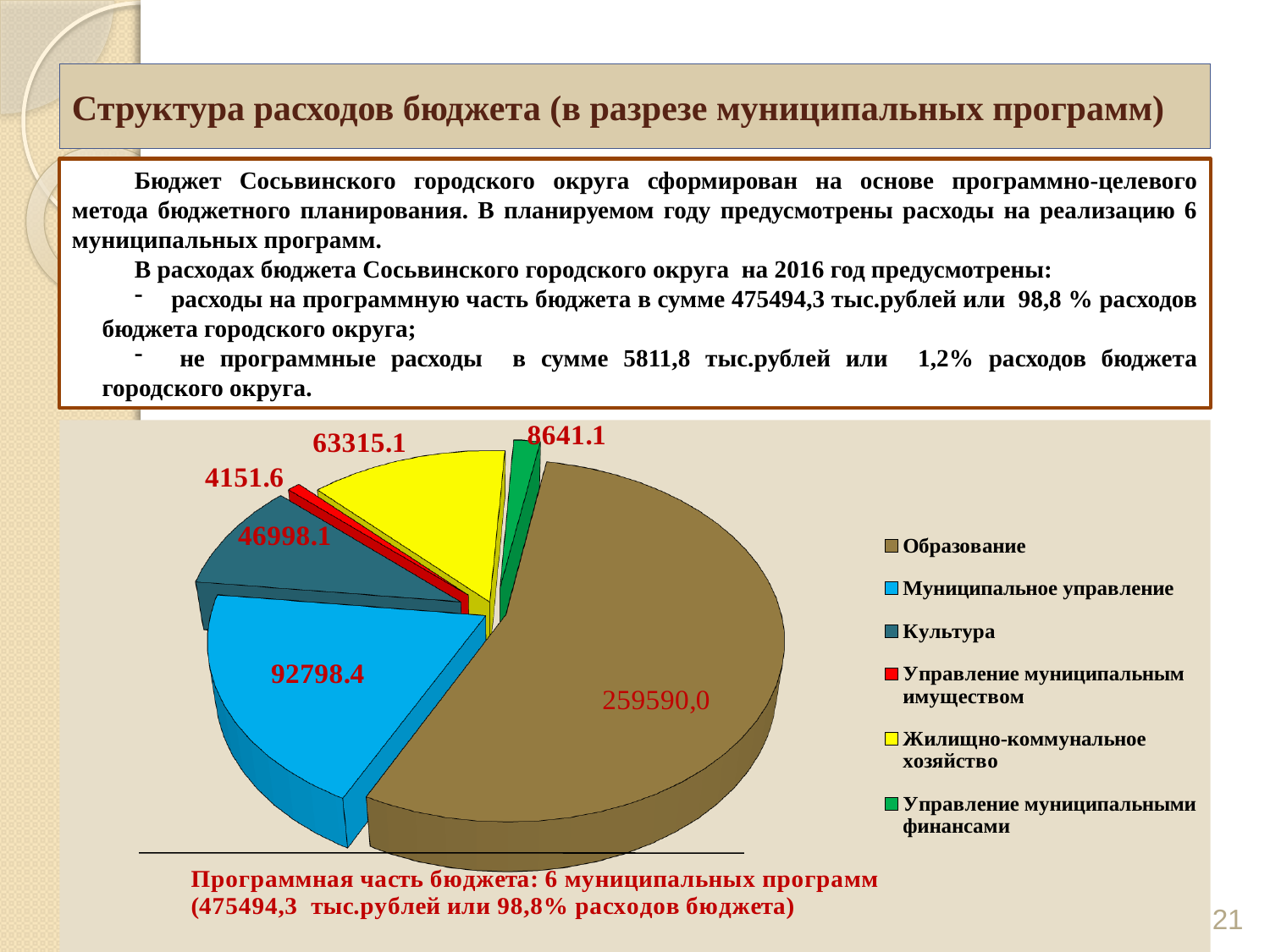
What is the value for Культура in the pie chart? 46998.1 What is the value for Управление муниципальными финансами in the pie chart? 8641.1 Which is larger, the value for Муниципальное управление or the value for Жилищно-коммунальное хозяйство? Муниципальное управление What is the value for Муниципальное управление in the pie chart? 92798.4 How many categories does the pie chart show? 6 What is the value for Жилищно-коммунальное хозяйство in the pie chart? 63315.1 What is the difference between the values for Муниципальное управление and Культура? 45800.3 Which category has the smallest slice in the pie chart? Управление муниципальным имуществом What colour is the slice for Управление муниципальным имуществом? red What type of chart is shown on the slide? pie chart What is the value for Образование in the pie chart? 259590,0 Which category has the largest slice in the pie chart? Образование